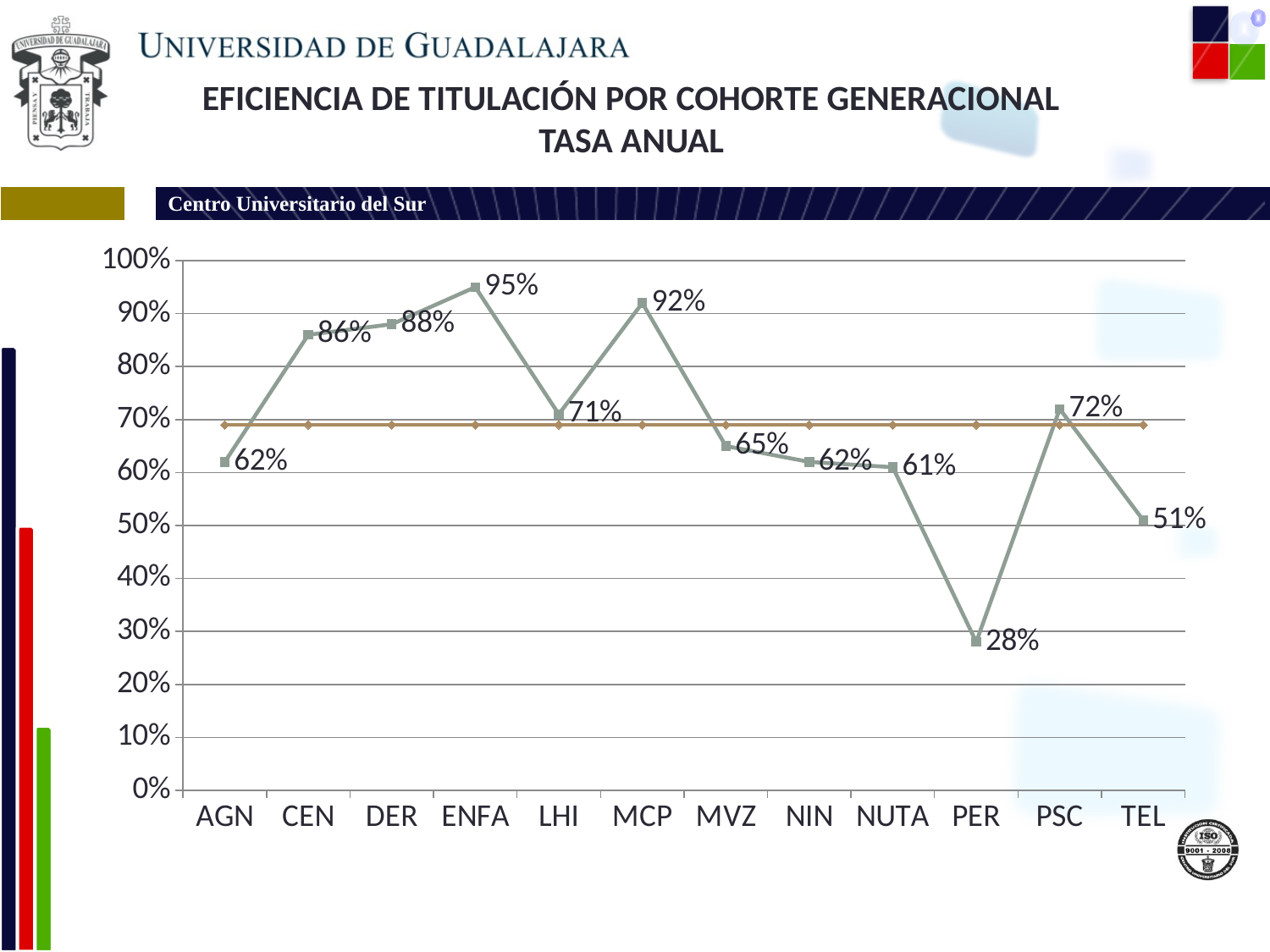
What is the value for TEL? 51% What kind of chart is shown on the slide? line chart Is the value for PSC greater or less than 70%? greater What is the value for ENFA? 95% What is the value for PER? 28% Which category has the lowest value? PER Which is larger, the value for CEN or the value for DER? DER What is the value for MCP? 92% What is the difference between the values for ENFA and PER? 67% How many categories are shown on the x axis? 12 Do the values rise or fall from NUTA to PER? fall Which category has the highest value? ENFA